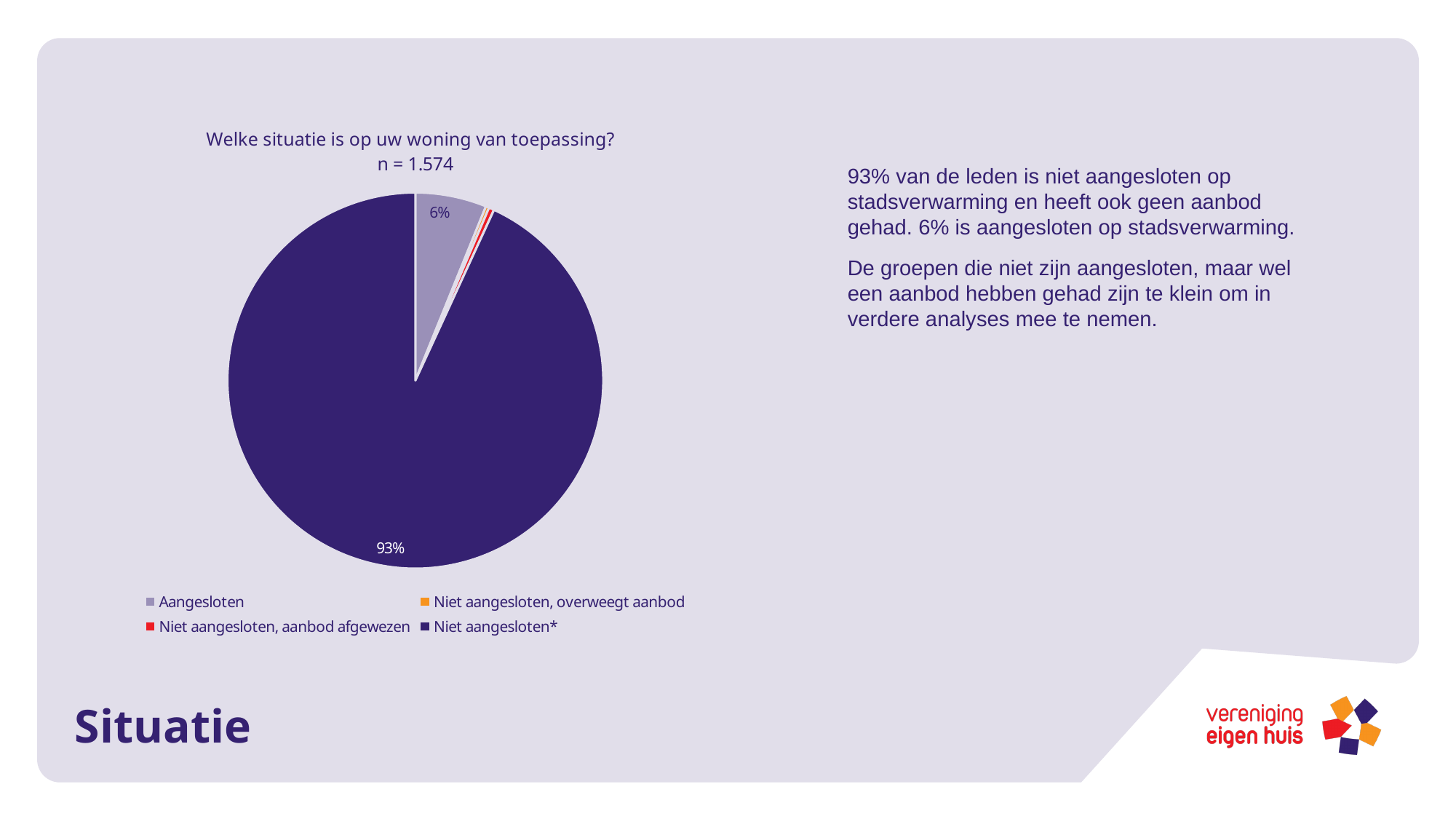
What kind of chart is shown on the slide? Pie chart Which category has the largest slice of the pie? Niet aangesloten* What share of the pie does the 'Niet aangesloten*' slice represent? 93% Which is larger, the 'Aangesloten' slice or the 'Niet aangesloten*' slice? Niet aangesloten* What is the title of the pie chart? Welke situatie is op uw woning van toepassing? What is the difference in percentage points between the 'Niet aangesloten*' slice and the 'Aangesloten' slice? 87 percentage points What sample size (n) is shown under the chart title? n = 1.574 How many categories does the legend of the pie chart list? 4 What share of the pie does the 'Aangesloten' slice represent? 6%